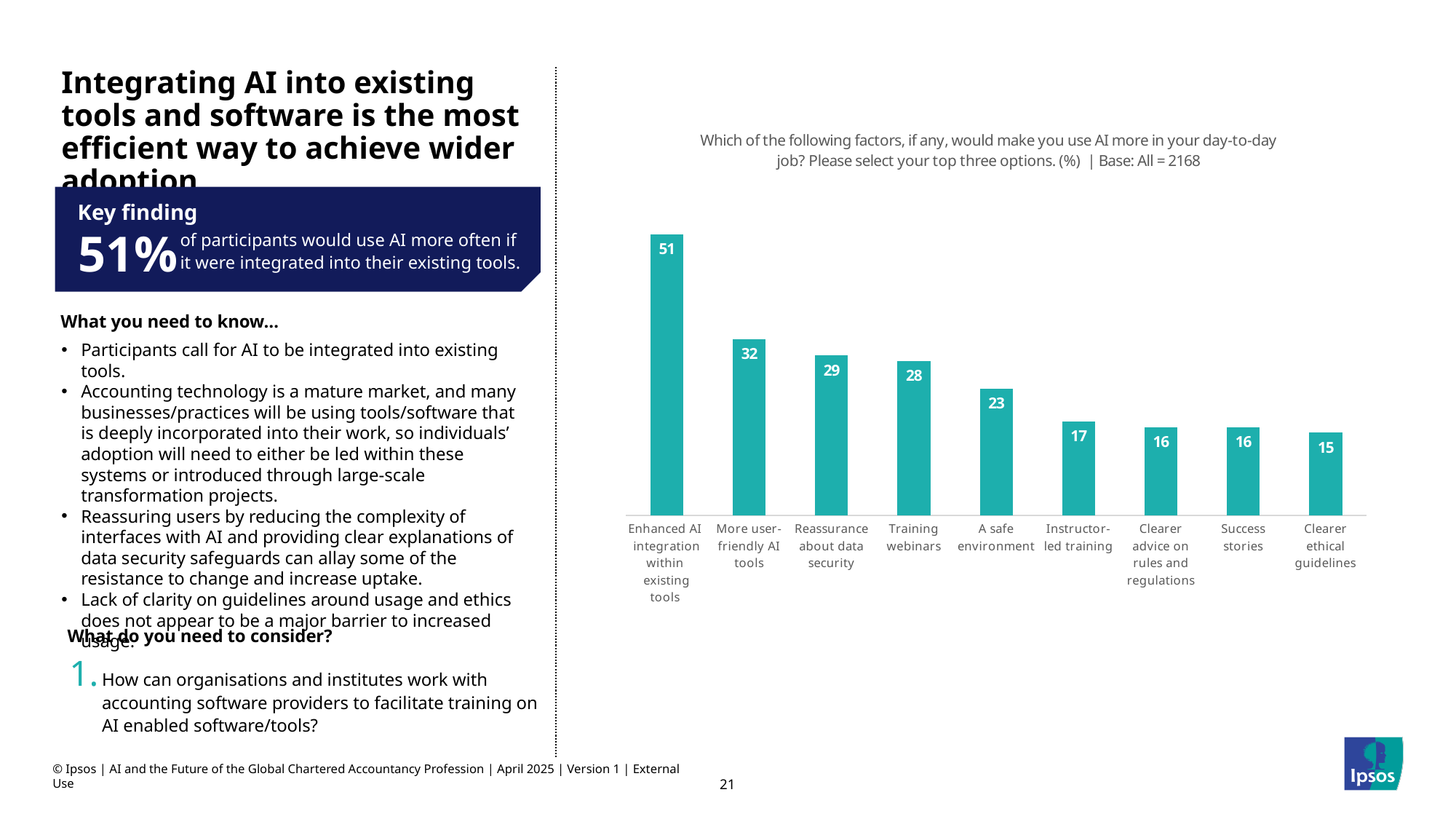
What is the difference between the values for 'Enhanced AI integration within existing tools' and 'Clearer ethical guidelines'? 36 What is the value for 'Enhanced AI integration within existing tools'? 51 What is the value for 'Clearer advice on rules and regulations'? 16 What kind of chart is shown on the slide? Bar chart What is the base size stated in the chart's question text? All = 2168 Do the values rise or fall from left to right across the categories? Fall What is the value for 'Training webinars'? 28 What is the difference between the values for 'More user-friendly AI tools' and 'Reassurance about data security'? 3 How many categories are shown in the chart? 9 Which category has the lowest value? Clearer ethical guidelines Which is larger, the value for 'A safe environment' or the value for 'Instructor-led training'? A safe environment Which category has the highest value? Enhanced AI integration within existing tools